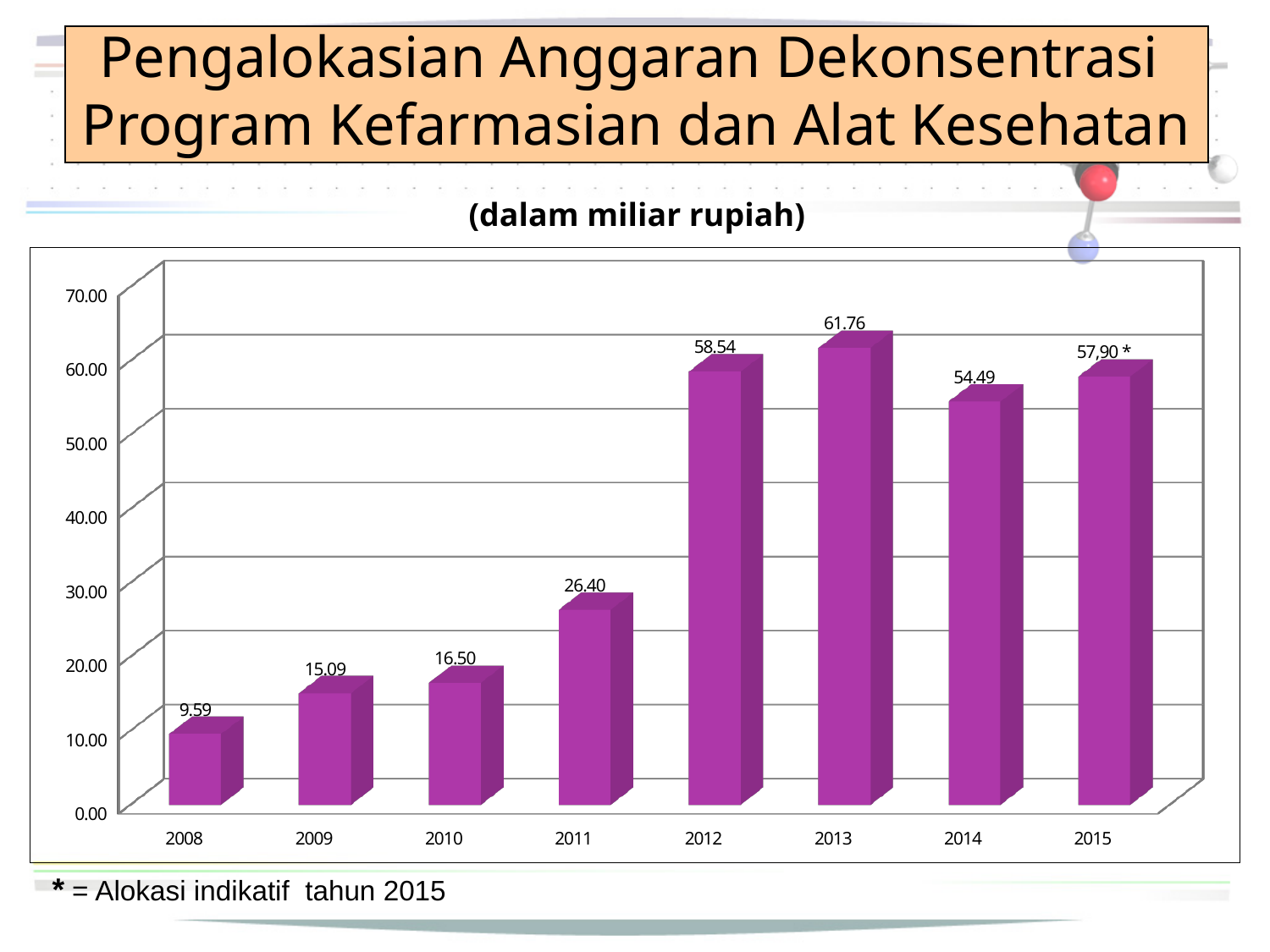
What is the value for 2011? 26.40 Which year has the lowest value? 2008 Which year has the highest value? 2013 What is the value for 2013? 61.76 Is the value for 2010 greater or less than 20.00? less What is the difference between the values for 2012 and 2011? 32.14 Do the values rise or fall from 2008 to 2013? rise How many years are shown on the x axis? 8 Which is larger, the value for 2012 or the value for 2014? 2012 What is the value shown for 2015? 57,90 * What is the value for 2008? 9.59 What kind of chart is shown? bar chart